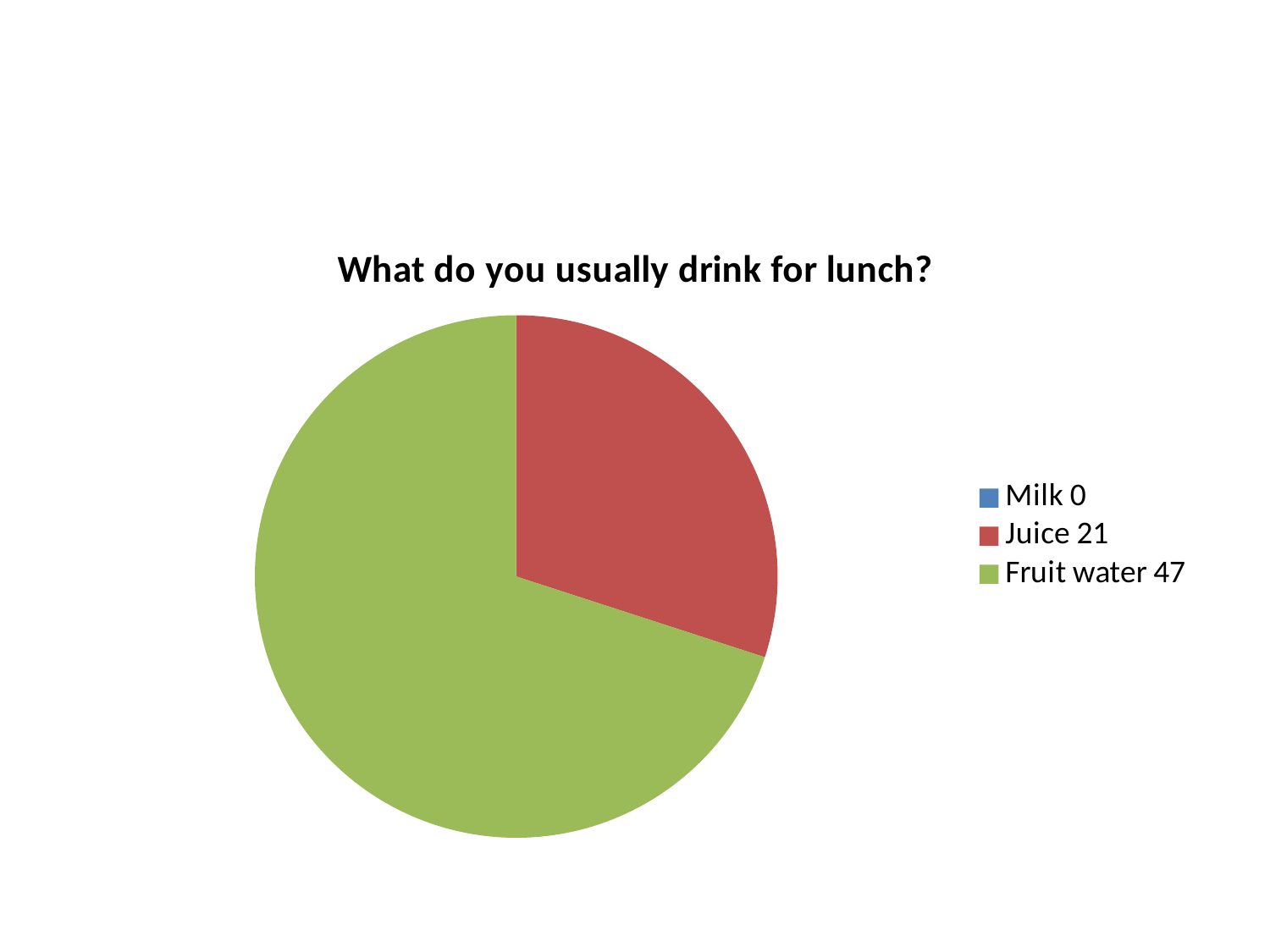
What is the difference between the values for Fruit water and Juice? 26 How many categories does the legend list? 3 What kind of chart is shown on the slide? pie chart Which category has the lowest value? Milk Which is larger, the value for Juice or the value for Fruit water? Fruit water What colour is the Juice slice? red What is the value for Fruit water? 47 What is the title of the chart? What do you usually drink for lunch? What is the total of all the values shown in the legend? 68 What is the value for Milk? 0 What is the value for Juice? 21 Which category has the highest value? Fruit water